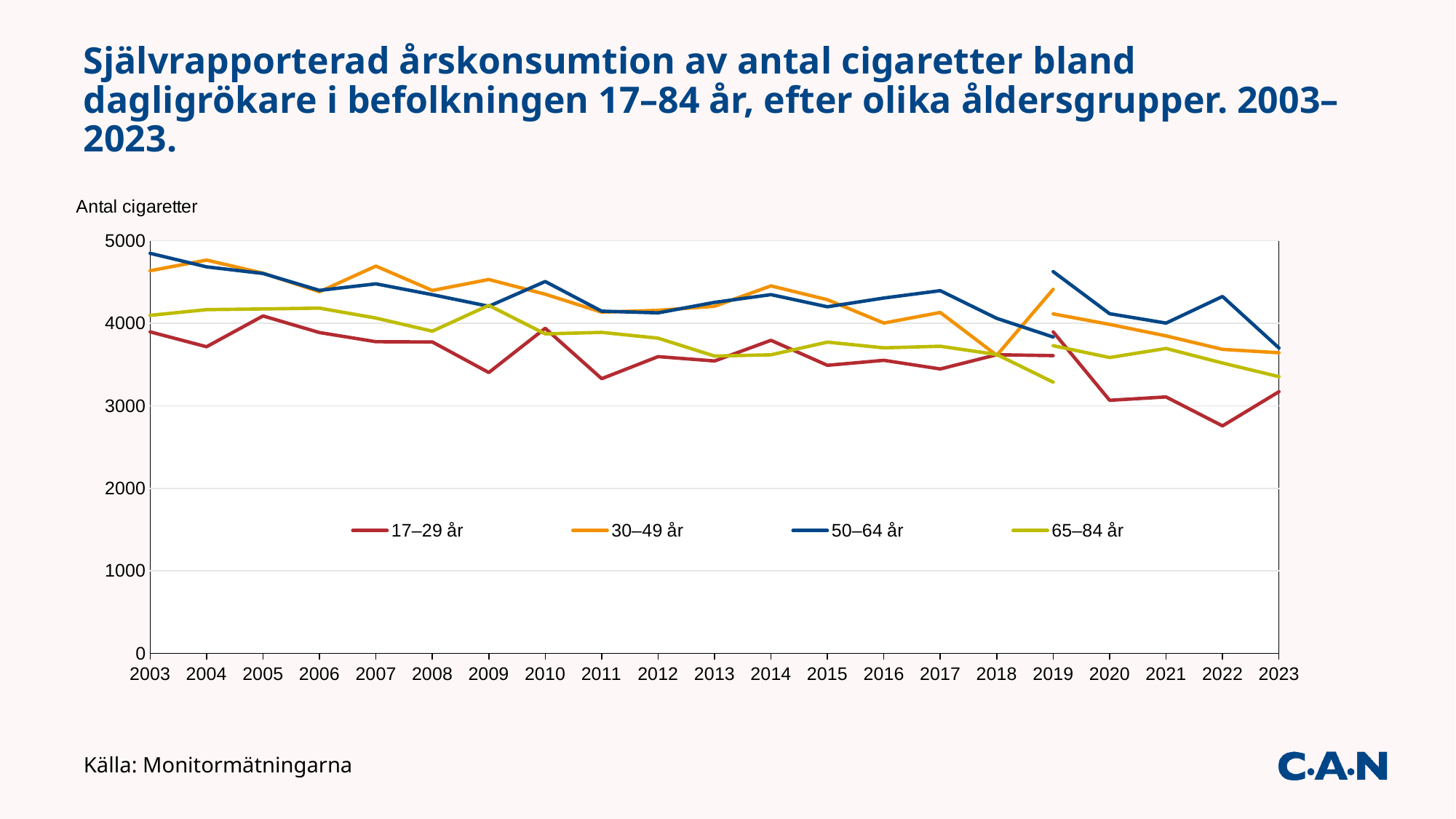
What kind of chart is shown on the slide? Line chart Is the value for 50–64 år in 2003 greater or less than 4000? greater Is the value for 17–29 år in 2009 greater or less than 4000? less Is the value for 30–49 år in 2007 greater or less than 4000? greater How many series does the legend list? 4 How many years are plotted along the x axis? 21 For 50–64 år, is the value larger in 2003 or in 2023? 2003 Which age group has the lowest value in 2022? 17–29 år Does the 17–29 år series generally rise or fall from 2003 to 2023? Fall Which age group has the highest value in 2022? 50–64 år Which age group has the highest value in 2003? 50–64 år